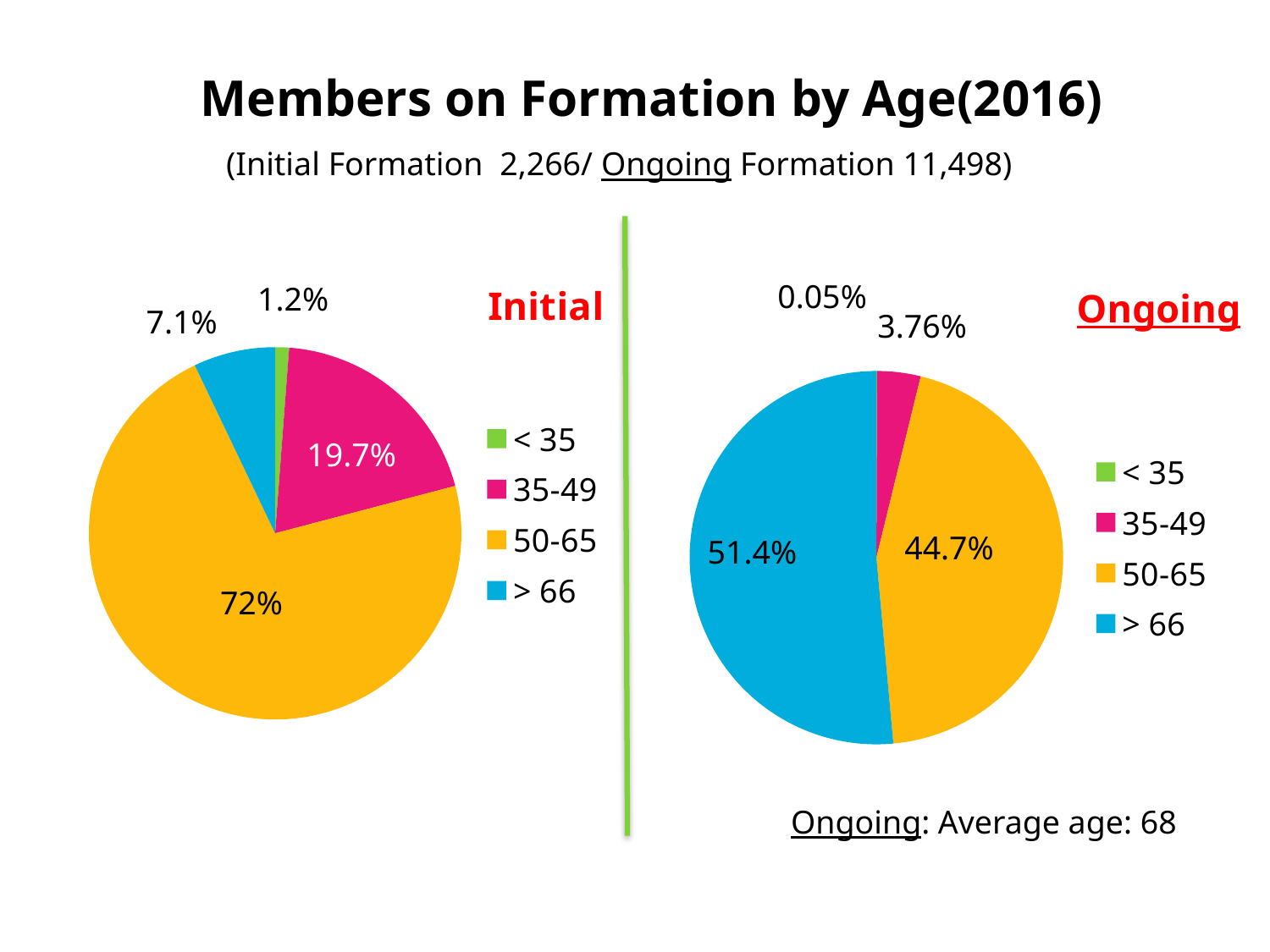
In the Ongoing pie chart, what is the difference between the > 66 share and the 50-65 share? 6.7% What colour represents the 50-65 age group in both pie charts? Yellow In the Initial pie chart, which age group has the largest share? 50-65 In the Initial pie chart, which is larger: the share for 35-49 or the share for > 66? 35-49 In the Initial pie chart, what share of members are aged 35-49? 19.7% What type of chart is used for the Initial formation data? Pie chart In the Ongoing pie chart, what share of members are aged > 66? 51.4% In the Initial pie chart, what share of members are aged 50-65? 72% In the Ongoing pie chart, what share of members are aged < 35? 0.05% In the Ongoing pie chart, which age group has the largest share? > 66 How many age groups does the legend of the Ongoing pie chart list? 4 In the Initial pie chart, which age group has the smallest share? < 35